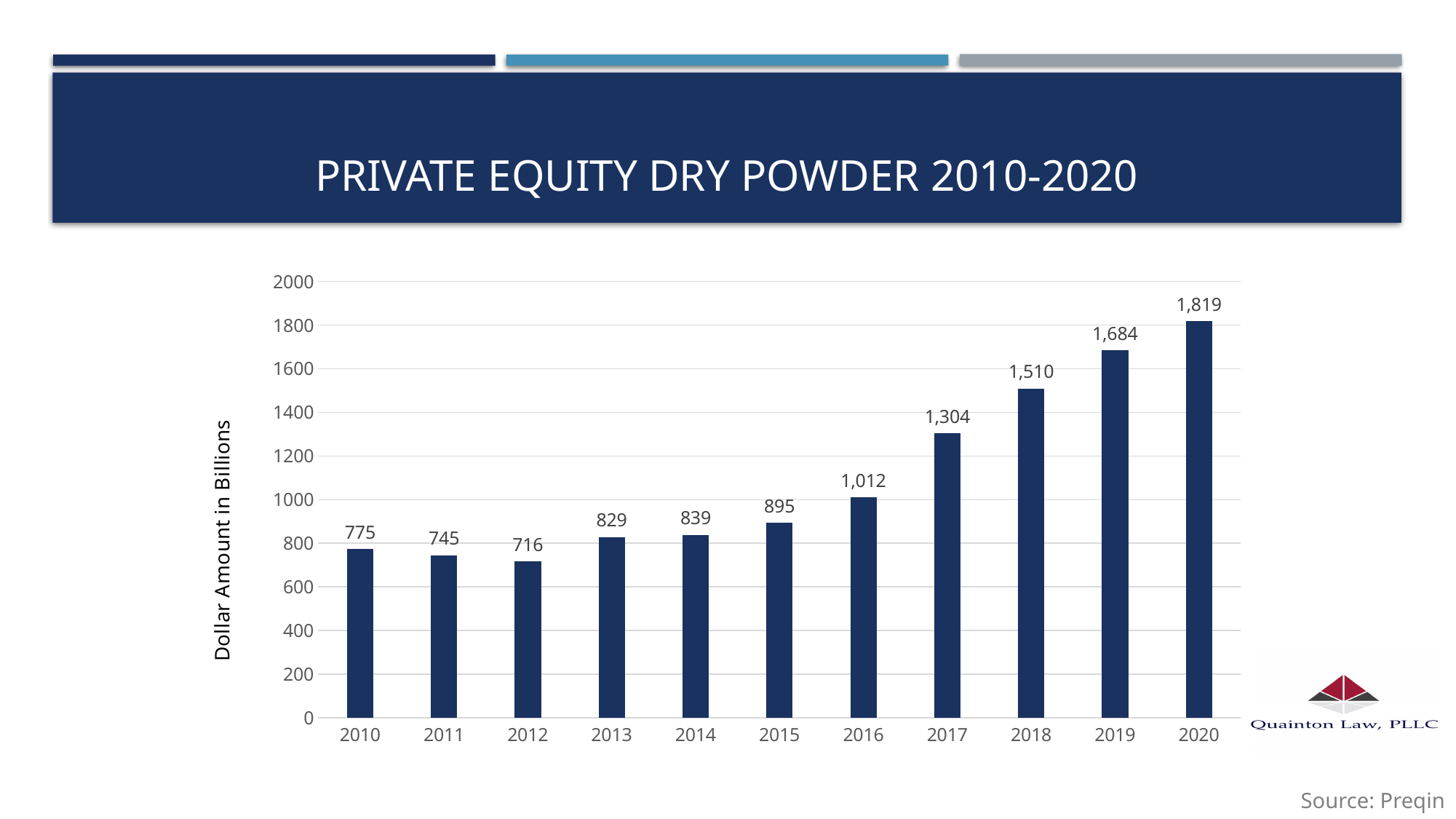
What is the value for 2016? 1,012 What is the label of the vertical axis? Dollar Amount in Billions What is the difference between the values for 2020 and 2019? 135 What is the value for 2019? 1,684 Is the value for 2017 greater or less than 1200? greater Which is larger, the value for 2013 or the value for 2014? 2014 What kind of chart is shown on the slide? Bar chart Which year has the highest value? 2020 How many years are shown on the x axis? 11 What is the difference between the values for 2018 and 2017? 206 What is the value for 2012? 716 Which year has the lowest value? 2012